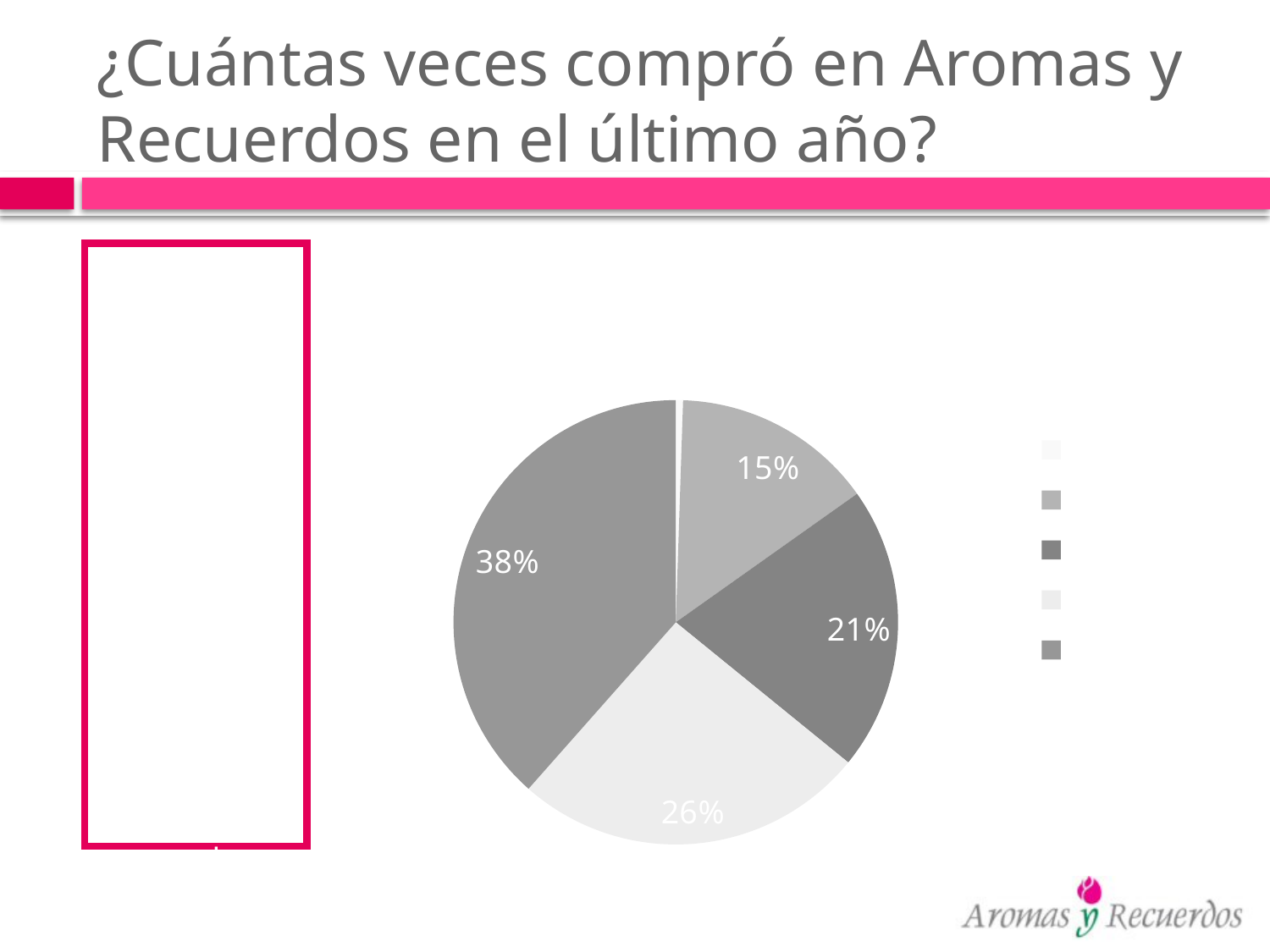
What is the percentage shown on the slice at the top right of the pie chart? 15% What is the percentage shown on the dark grey slice on the right side of the pie chart? 21% What is the title of the slide containing the pie chart? ¿Cuántas veces compró en Aromas y Recuerdos en el último año? What is the difference in percentage points between the 26% slice and the 21% slice? 5 Is the largest slice of the pie chart greater or less than 50%? less What kind of chart is shown on the slide? pie chart What is the percentage shown on the largest slice of the pie chart? 38% How many entries does the legend of the pie chart list? 5 What is the percentage shown on the light-coloured slice at the bottom of the pie chart? 26% What is the difference in percentage points between the 38% slice and the 15% slice? 23 Which is larger: the slice labelled 21% or the slice labelled 26%? 26% How many slices of the pie chart have a percentage label printed on them? 4